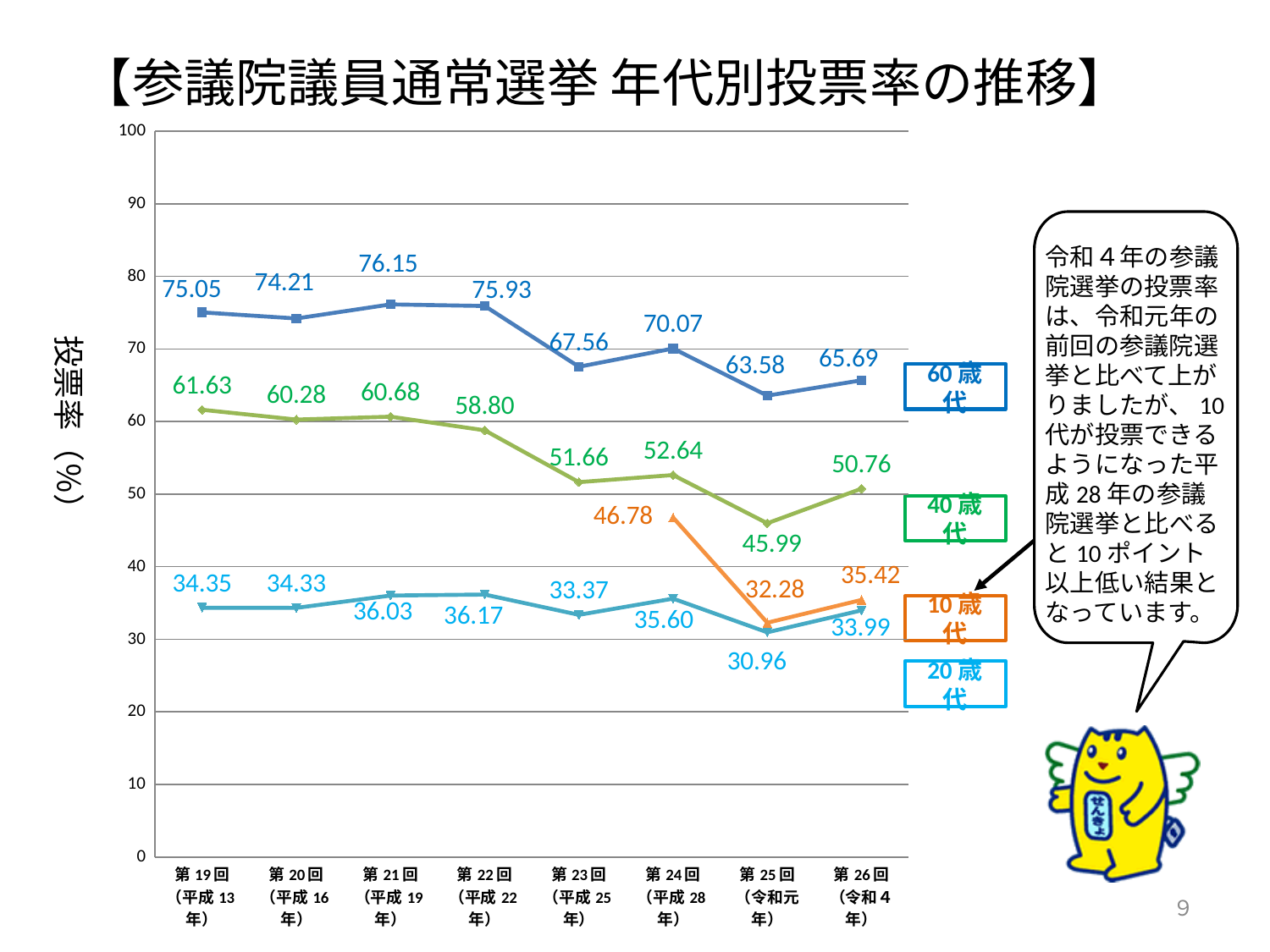
Does the 40歳代 series rise or fall from 第19回 (平成13年) to 第25回 (令和元年)? fall Which is larger at 第26回 (令和4年): the 10歳代 value or the 20歳代 value? 10歳代 At which election does the 60歳代 series reach its highest value? 第21回 (平成19年) What is the difference between the 10歳代 values at 第24回 (平成28年) and 第26回 (令和4年)? 11.36 What type of chart is shown on the slide? line chart What is the turnout value for the 10歳代 series at 第24回 (平成28年)? 46.78 At which election does the 20歳代 series reach its lowest value? 第25回 (令和元年) How many age-group series are plotted on the chart? 4 What is the turnout value for the 20歳代 series at 第26回 (令和4年)? 33.99 What is the turnout value for the 40歳代 series at 第25回 (令和元年)? 45.99 What is the turnout value for the 60歳代 series at 第21回 (平成19年)? 76.15 How many elections are shown on the x axis? 8